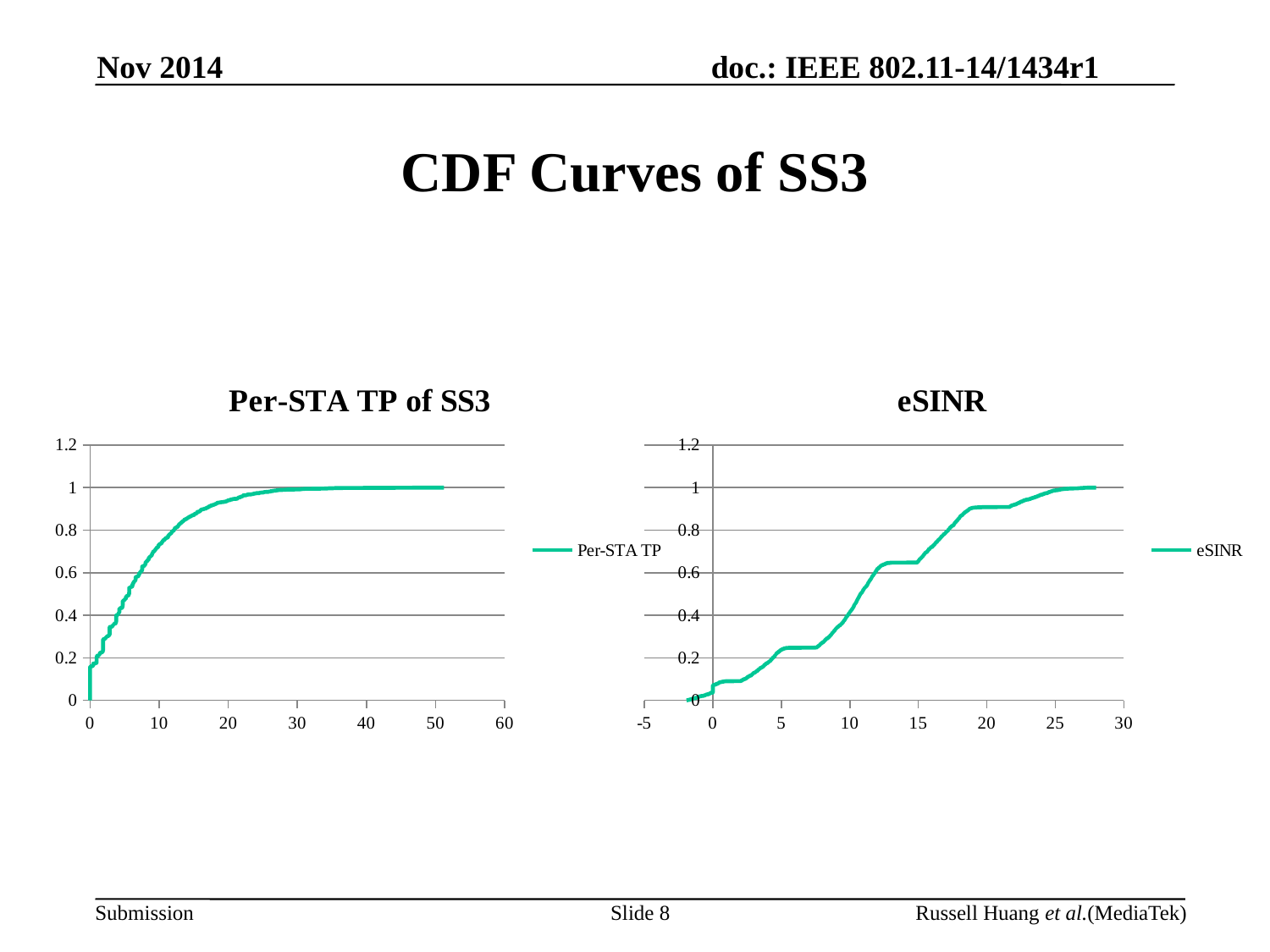
In the 'eSINR' chart, is the value at x = 20 greater or less than 0.8? greater In the 'eSINR' chart, is the value at x = 0 greater or less than 0.2? less How many series does the legend of the 'Per-STA TP of SS3' chart list? 1 What kind of chart is the 'eSINR' chart? line chart In the 'Per-STA TP of SS3' chart, is the value at x = 20 greater or less than 0.8? greater What is the title of the chart on the left? Per-STA TP of SS3 What kind of chart is the 'Per-STA TP of SS3' chart? line chart How many series does the legend of the 'eSINR' chart list? 1 What is the legend entry of the chart on the right? eSINR In the 'eSINR' chart, do the values rise or fall as x increases? rise In the 'Per-STA TP of SS3' chart, do the values rise or fall as x increases? rise